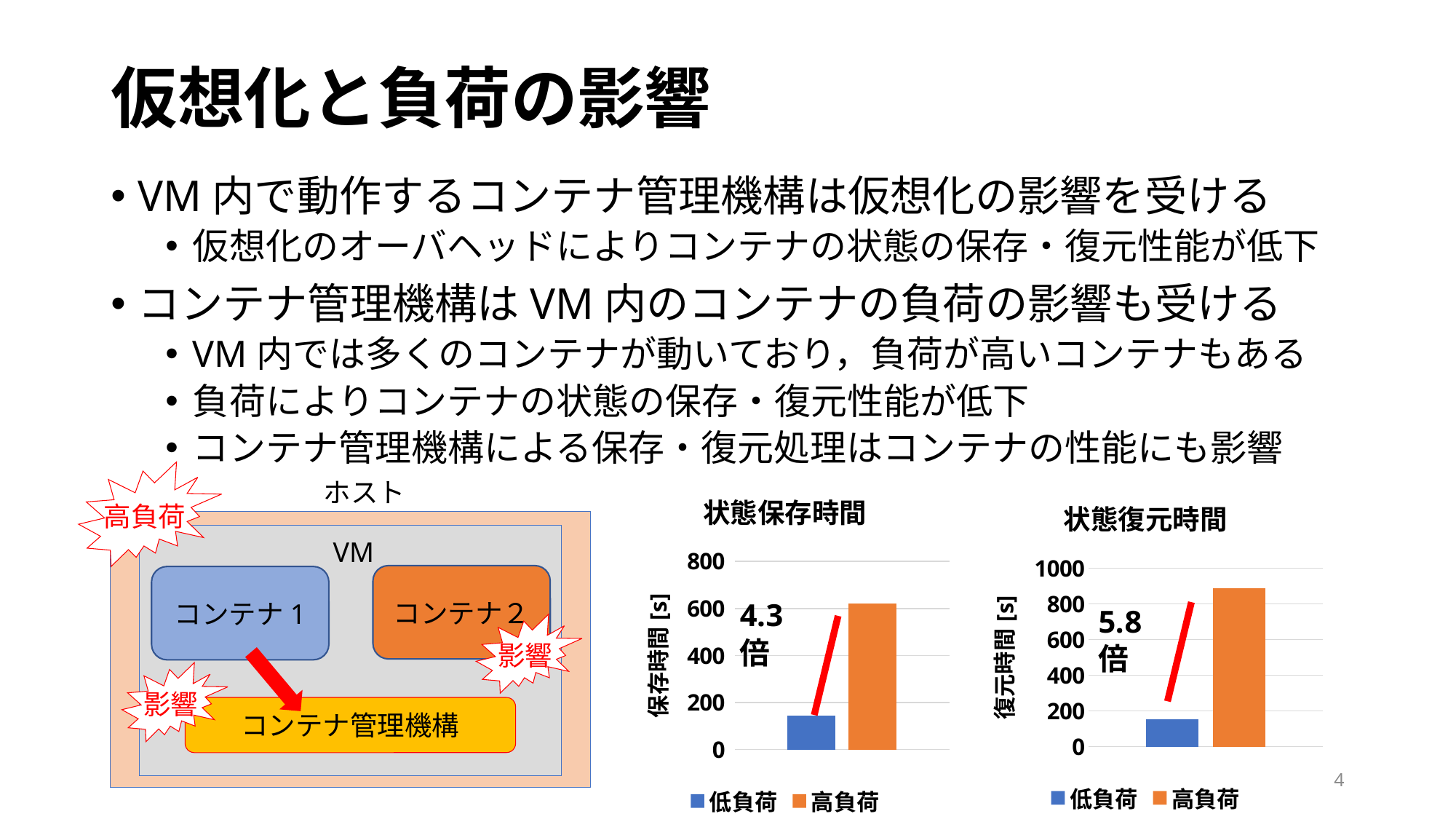
In the 状態保存時間 chart, is the value for 高負荷 greater or less than 400? greater In the 状態復元時間 chart, is the value for 高負荷 greater or less than 600? greater In the 状態保存時間 chart, how many bars are plotted? 2 In the 状態復元時間 chart, is the value for 低負荷 greater or less than 400? less In the 状態復元時間 chart, which series has the highest value? 高負荷 In the 状態復元時間 chart, which series has the lowest value? 低負荷 In the 状態保存時間 chart, which series has the higher value, 低負荷 or 高負荷? 高負荷 In the 状態復元時間 chart, how many series does the legend list? 2 In the 状態保存時間 chart, what kind of chart is shown? bar chart In the 状態復元時間 chart, what is the label on the vertical axis? 復元時間 [s] In the 状態保存時間 chart, what ratio is annotated between the two bars? 4.3倍